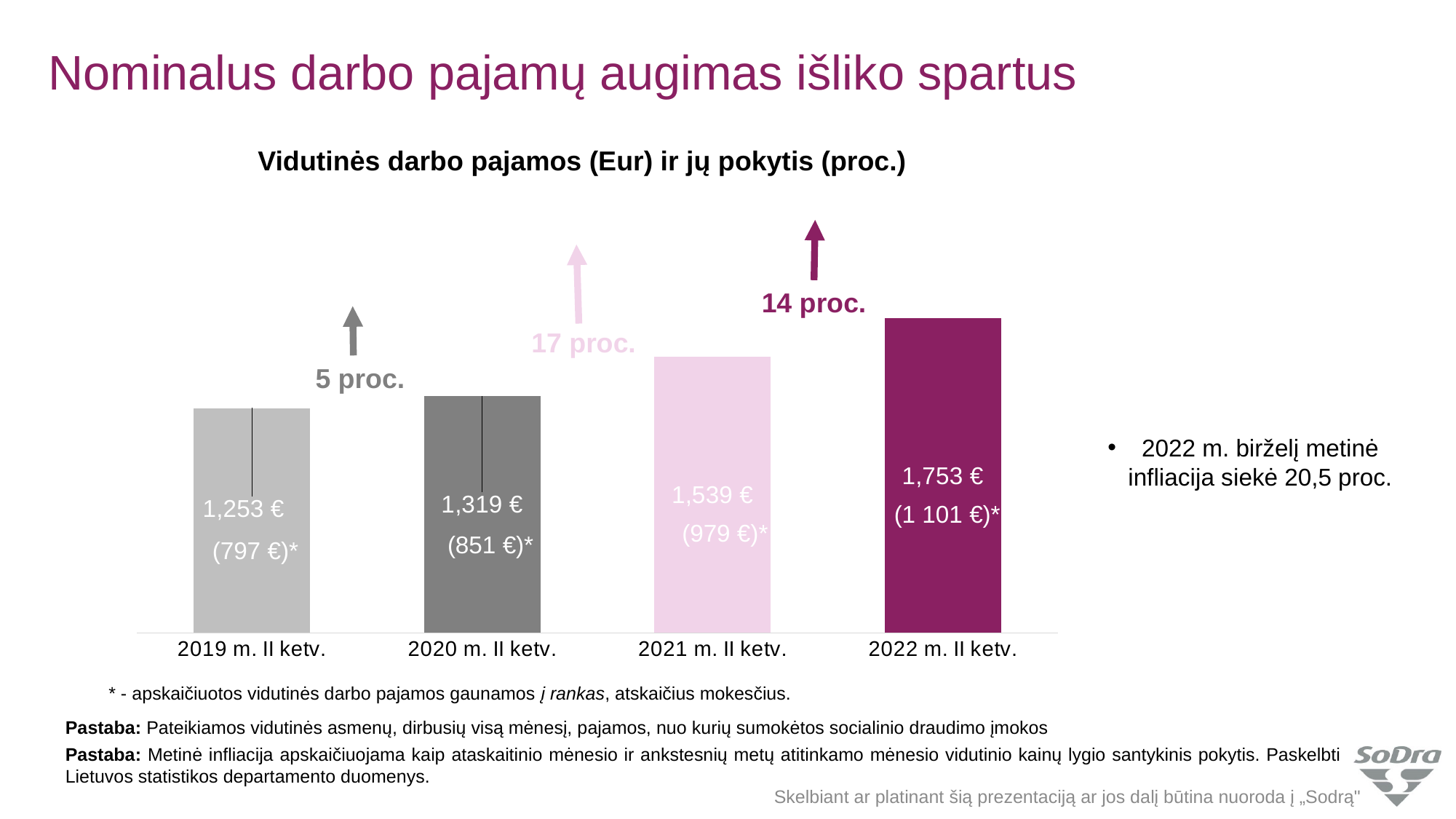
What percentage change is shown between 2020 m. II ketv. and 2021 m. II ketv.? 17 proc. What is the average labour income shown for 2022 m. II ketv.? 1,753 € Do the average labour income values rise or fall from 2019 m. II ketv. to 2022 m. II ketv.? Rise Which quarter has the highest average labour income? 2022 m. II ketv. What percentage change is shown between 2019 m. II ketv. and 2020 m. II ketv.? 5 proc. What is the difference in average labour income between 2022 m. II ketv. and 2021 m. II ketv.? 214 € What is the average labour income shown for 2019 m. II ketv.? 1,253 € What net (in-hand) income is shown in parentheses for 2021 m. II ketv.? 979 € What kind of chart is shown on the slide? Bar chart Which quarter has the lowest average labour income? 2019 m. II ketv. Which is larger, the average labour income for 2020 m. II ketv. or for 2021 m. II ketv.? 2021 m. II ketv. How many quarters are shown on the chart? 4